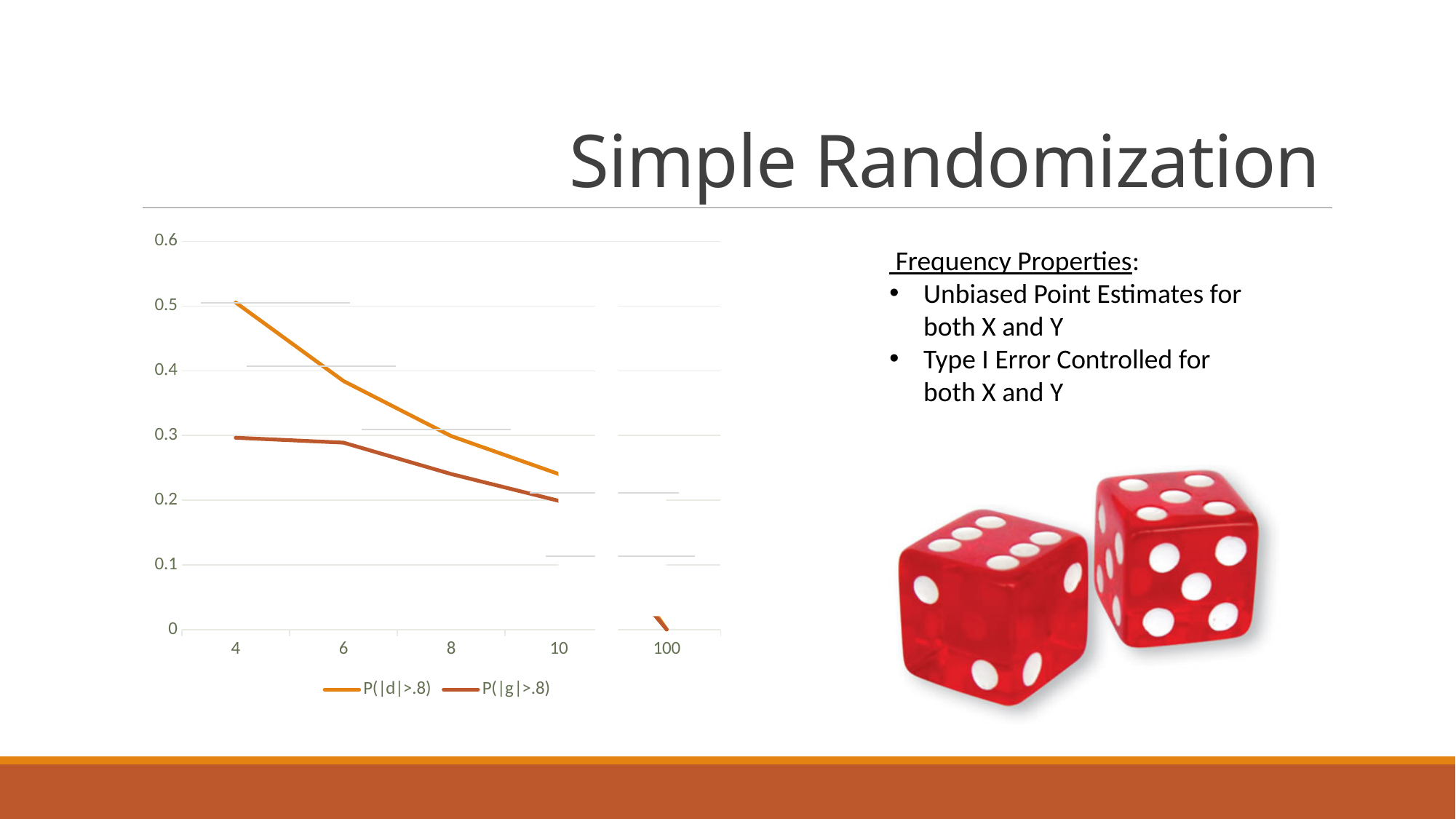
Is the value of P(|d|>.8) at x = 100 greater or less than 0.1? less What are the two series named in the chart legend? P(|d|>.8) and P(|g|>.8) At x = 4, which series has the larger value, P(|d|>.8) or P(|g|>.8)? P(|d|>.8) At x = 8, which series has the larger value, P(|d|>.8) or P(|g|>.8)? P(|d|>.8) What kind of chart is shown on the slide? line chart Does the P(|d|>.8) series rise or fall as the x-axis value increases from 4 to 10? fall Is the value of P(|d|>.8) at x = 4 greater or less than 0.4? greater How many series does the chart legend list? 2 At which x-axis value is P(|d|>.8) highest? 4 Is the value of P(|g|>.8) at x = 4 greater or less than 0.4? less How many x-axis categories are shown on the chart? 5 Does the P(|g|>.8) series rise or fall as the x-axis value increases from 4 to 10? fall